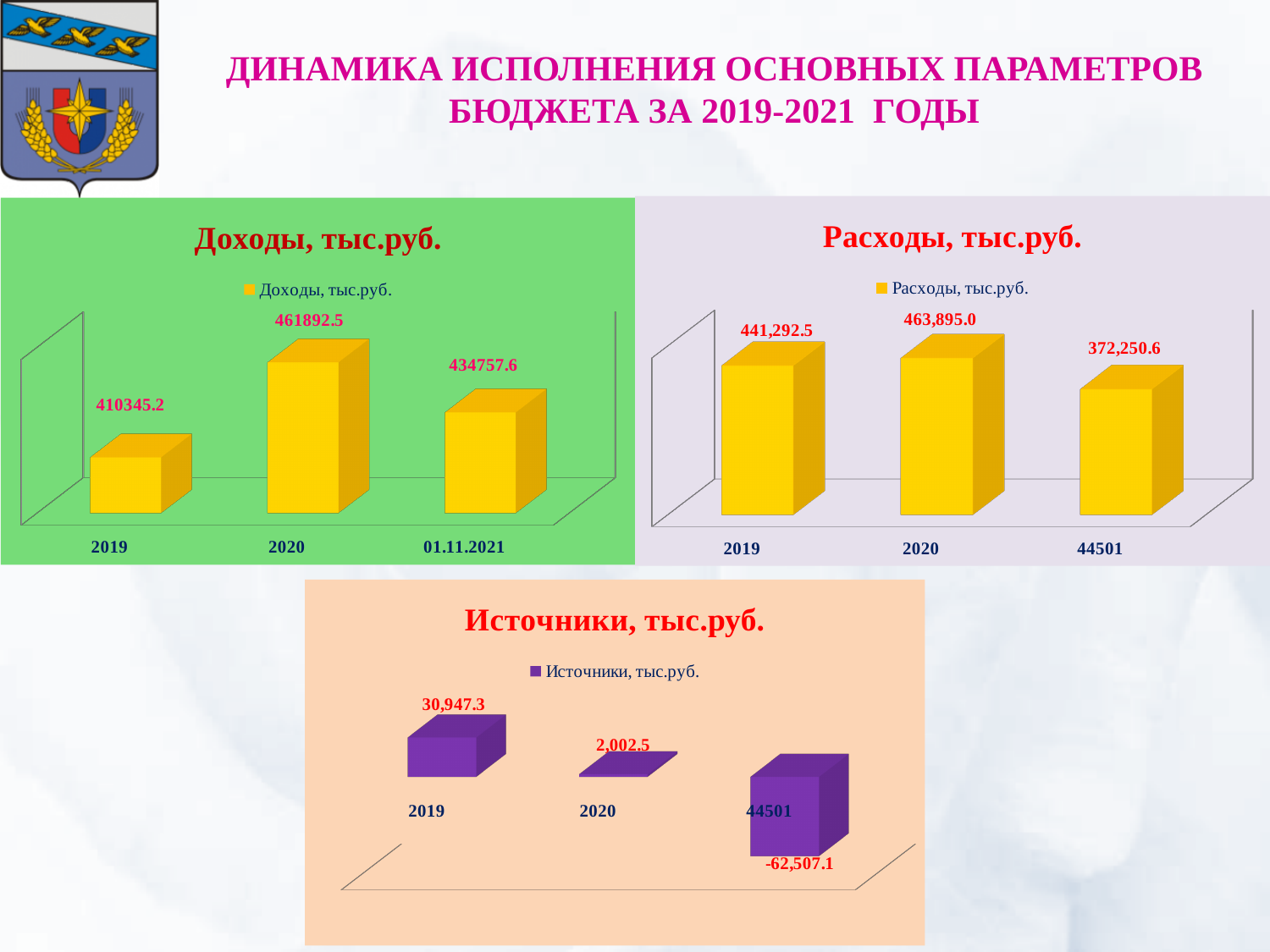
In the "Источники, тыс.руб." chart, what is the value for 44501? -62,507.1 In the "Источники, тыс.руб." chart, what is the value for 2020? 2,002.5 In the "Расходы, тыс.руб." chart, which category has the highest value? 2020 In the "Доходы, тыс.руб." chart, which category has the lowest value? 2019 In the "Доходы, тыс.руб." chart, what is the difference between the 2020 and 2019 values? 51547.3 In the "Расходы, тыс.руб." chart, what is the value for 2019? 441,292.5 How many categories does the "Источники, тыс.руб." chart show? 3 In the "Расходы, тыс.руб." chart, which is larger: the value for 2019 or the value for 44501? 2019 In the "Доходы, тыс.руб." chart, what is the value for 2020? 461892.5 In the "Доходы, тыс.руб." chart, what is the value for 01.11.2021? 434757.6 What type of chart is the "Доходы, тыс.руб." chart? Bar chart In the "Расходы, тыс.руб." chart, what is the difference between the 2020 and 44501 values? 91,644.4